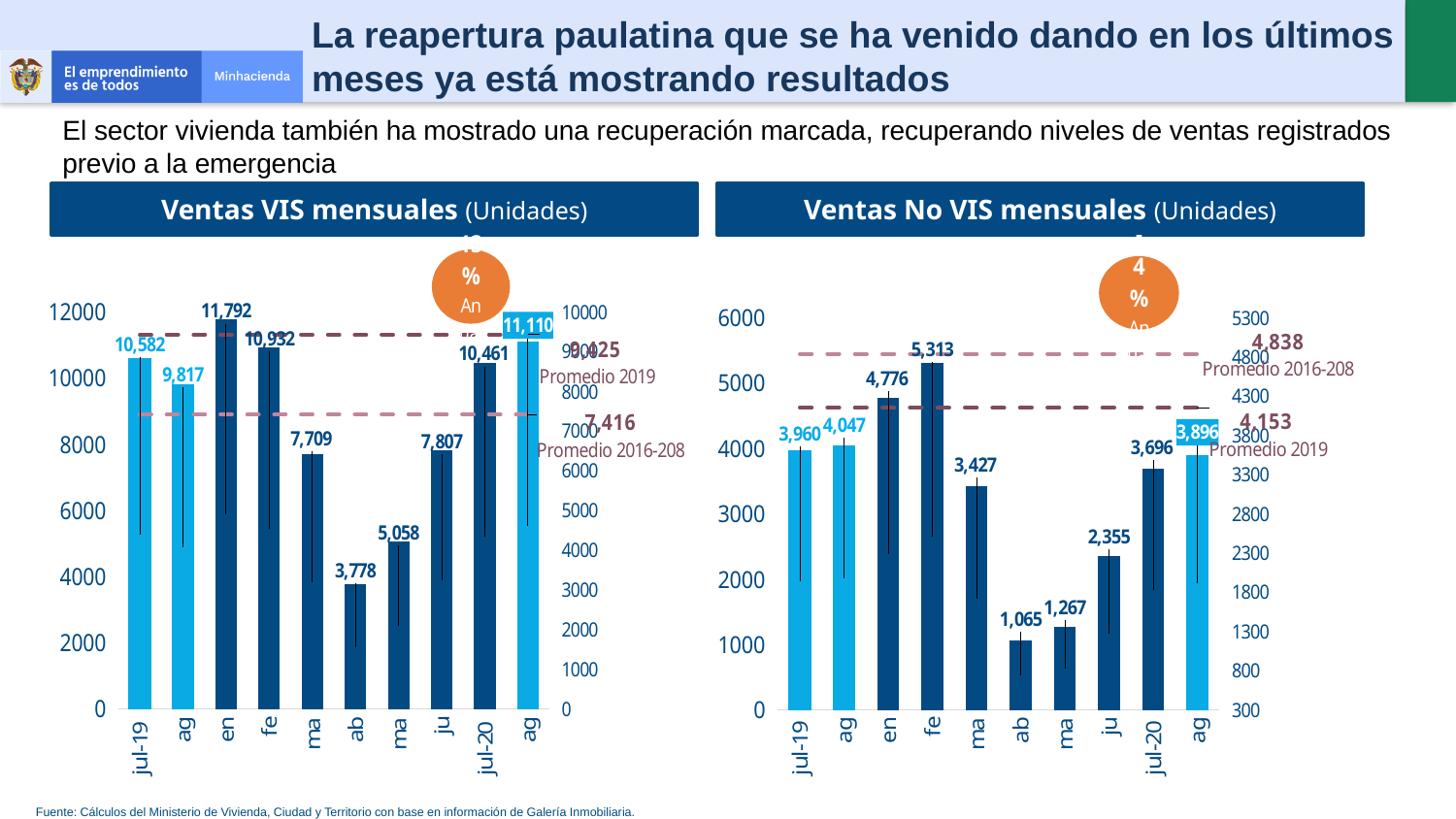
In the 'Ventas No VIS mensuales' chart, which month has the highest value? fe In the 'Ventas VIS mensuales' chart, what is the difference between the values for jul-20 and ab? 6,683 In the 'Ventas VIS mensuales' chart, which month has the highest value? en In the 'Ventas No VIS mensuales' chart, which month has the lowest value? ab How many bars are plotted in the 'Ventas VIS mensuales' chart? 10 In the 'Ventas VIS mensuales' chart, what is the value for en? 11,792 In the 'Ventas VIS mensuales' chart, is the value for ju greater or less than 8000? less In the 'Ventas No VIS mensuales' chart, what is the difference between the values for fe and ab? 4,248 What type of chart is the 'Ventas No VIS mensuales' chart? bar chart In the 'Ventas No VIS mensuales' chart, which is larger, the value for jul-19 or the value for jul-20? jul-19 In the 'Ventas No VIS mensuales' chart, what is the value for fe? 5,313 In the 'Ventas VIS mensuales' chart, which month has the lowest value? ab